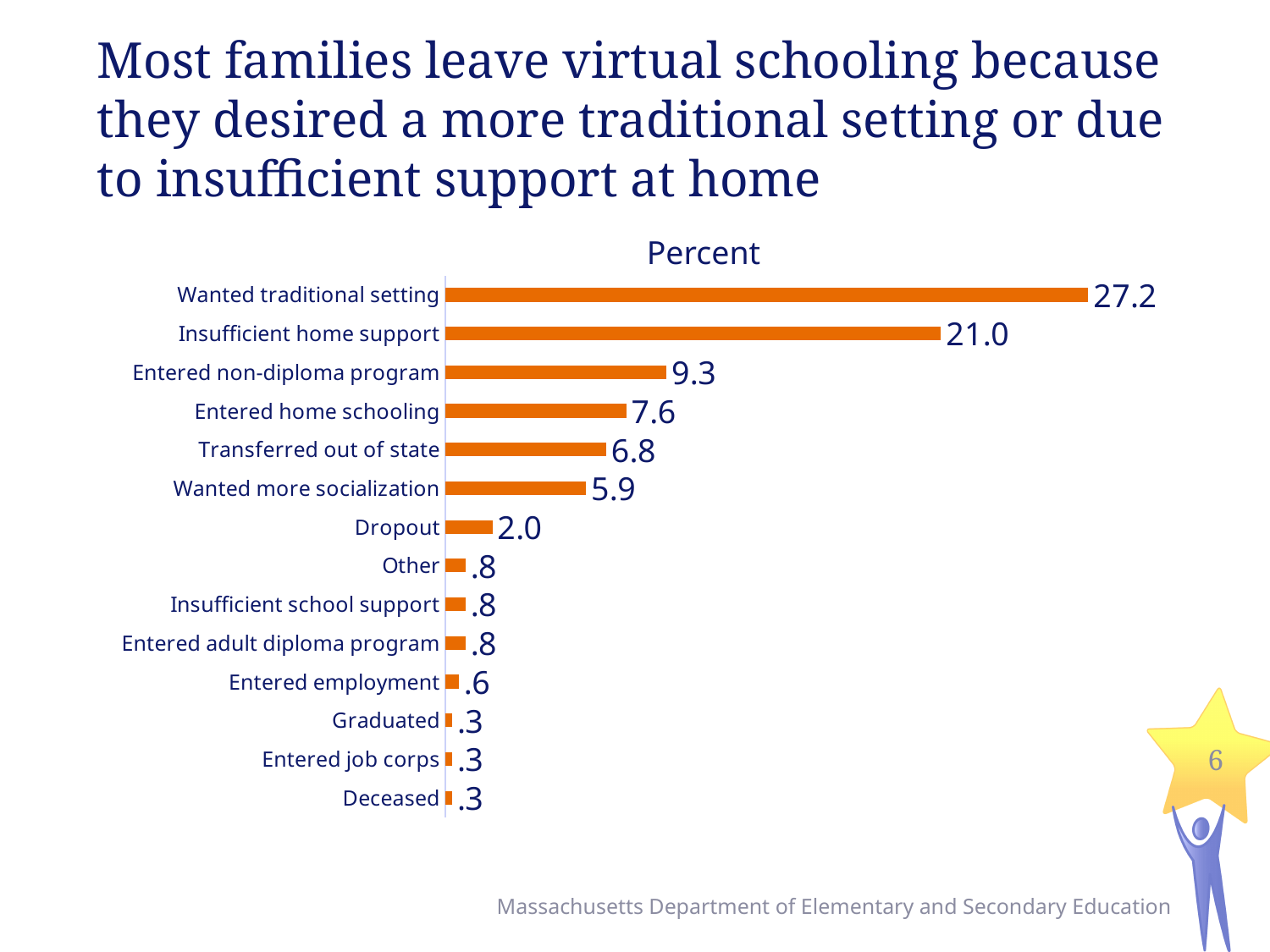
What is the value for Entered home schooling? 7.6 What is the difference between the values for Entered non-diploma program and Wanted more socialization? 3.4 Which category has the highest value? Wanted traditional setting What is the difference between the values for Wanted traditional setting and Insufficient home support? 6.2 What is the value for Dropout? 2.0 What is the value for Wanted traditional setting? 27.2 Which is larger, the value for Transferred out of state or the value for Entered home schooling? Entered home schooling What is the value for Entered employment? .6 What is the title of the chart? Percent What is the value for Insufficient home support? 21.0 What kind of chart is shown on the slide? Bar chart How many categories are shown in the chart? 14